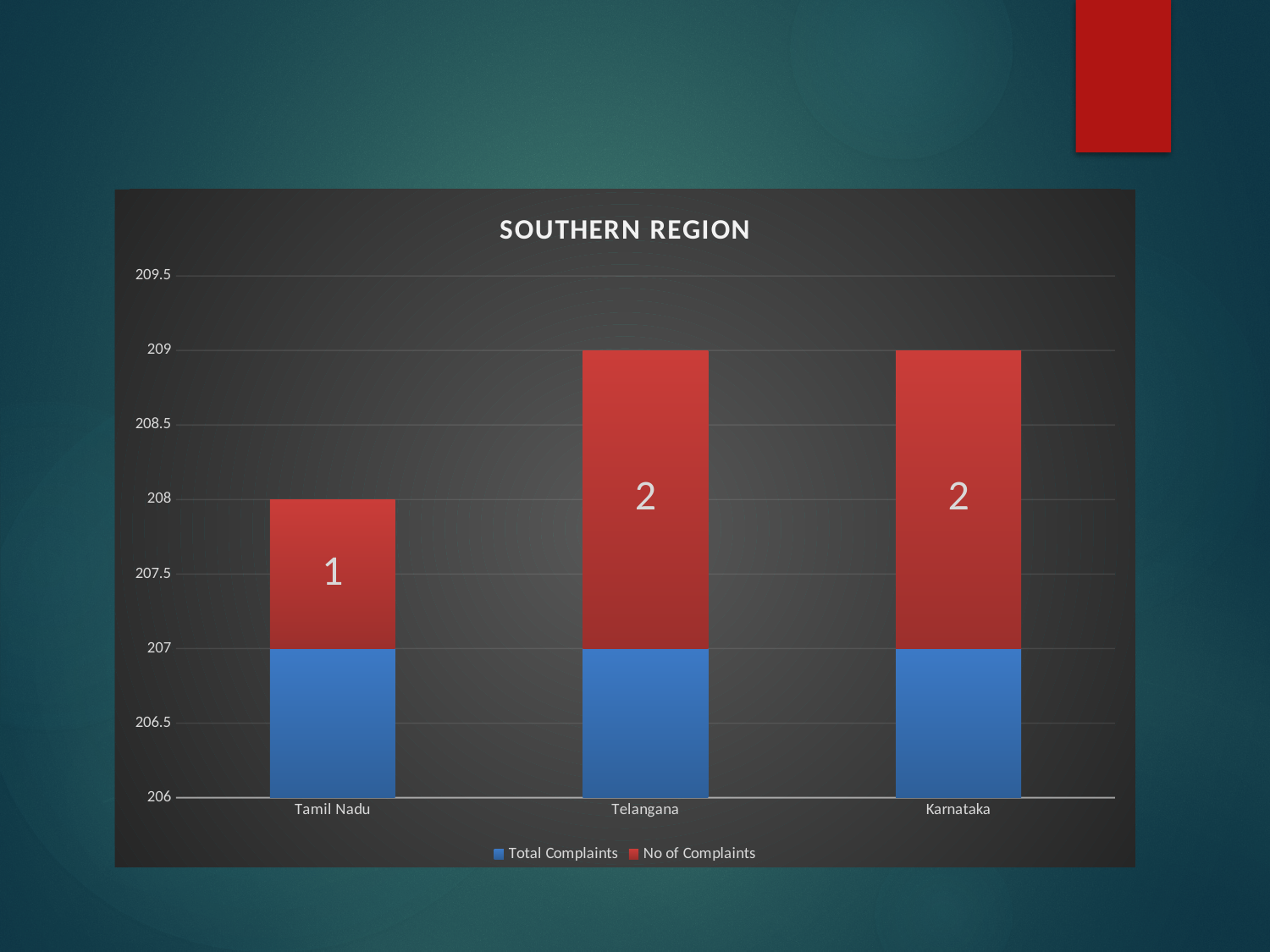
What is the Total Complaints value for Tamil Nadu, as read from the axis? 207 How many series does the legend list? 2 What is the No of Complaints value for Karnataka? 2 What is the title of the chart? SOUTHERN REGION Which colour represents the No of Complaints series? Red What kind of chart is shown on the slide? Stacked bar chart Is the No of Complaints value for Telangana larger or smaller than that for Tamil Nadu? larger How many categories are shown on the x axis? 3 What is the No of Complaints value for Telangana? 2 Which category has the lowest No of Complaints value? Tamil Nadu What is the No of Complaints value for Tamil Nadu? 1 What is the difference between the No of Complaints values for Telangana and Tamil Nadu? 1